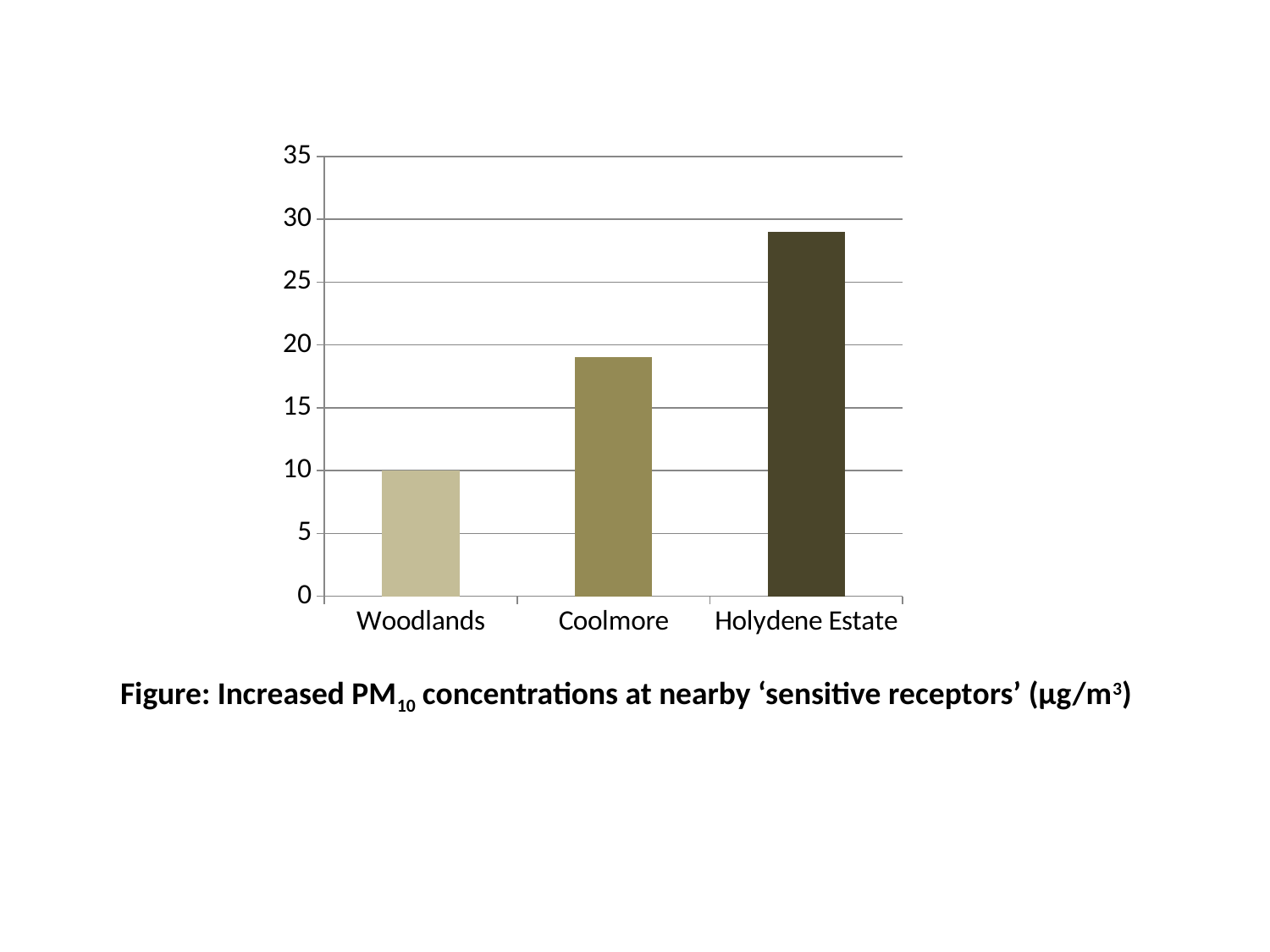
Which is larger, the value for Coolmore or the value for Holydene Estate? Holydene Estate Is the value for Coolmore greater or less than 15? greater Which category has the highest bar in the chart? Holydene Estate Which category has the lowest bar in the chart? Woodlands What kind of chart is shown on the slide? bar chart What is the value for Woodlands in the chart? 10 How many categories are shown on the x axis of the chart? 3 What unit is given in the figure caption below the chart? μg/m³ Is the value for Holydene Estate greater or less than 30? less Is the value for Holydene Estate greater or less than 25? greater Do the bar values rise or fall from left to right across the x axis? rise